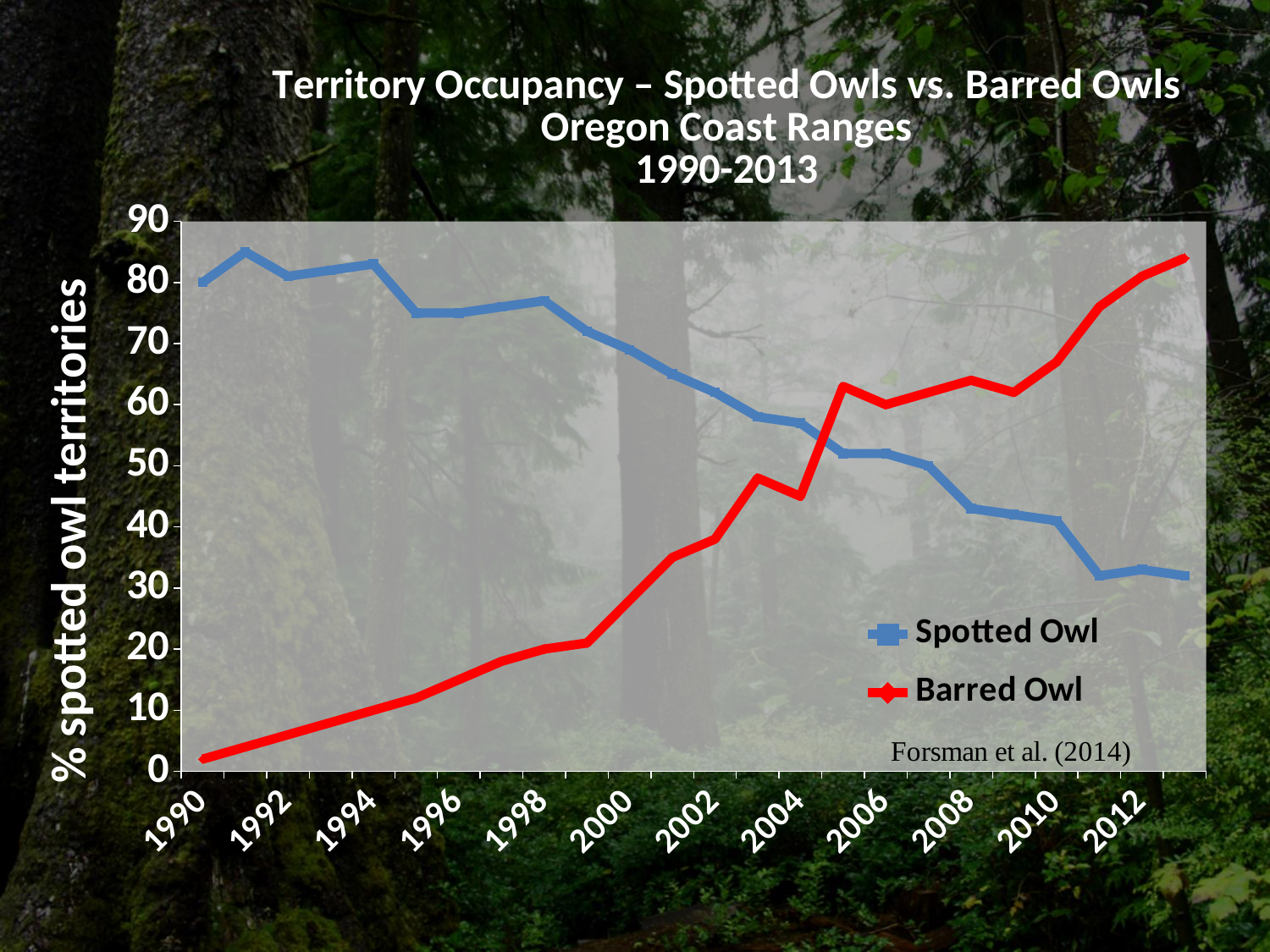
Is the Spotted Owl value for 1990 greater or less than 70? greater In 2012, which series has the higher value, Spotted Owl or Barred Owl? Barred Owl In 1990, which series has the higher value, Spotted Owl or Barred Owl? Spotted Owl What kind of chart is shown on the slide? Line chart Which two series are shown in the legend? Spotted Owl and Barred Owl Is the Spotted Owl value for 2012 greater or less than 40? less Does the Barred Owl line rise or fall from 1990 to 2012? Rise Is the Barred Owl value for 1990 greater or less than 10? less How many series does the legend list? 2 What is the label on the vertical axis? % spotted owl territories Does the Spotted Owl line rise or fall from 1990 to 2012? Fall